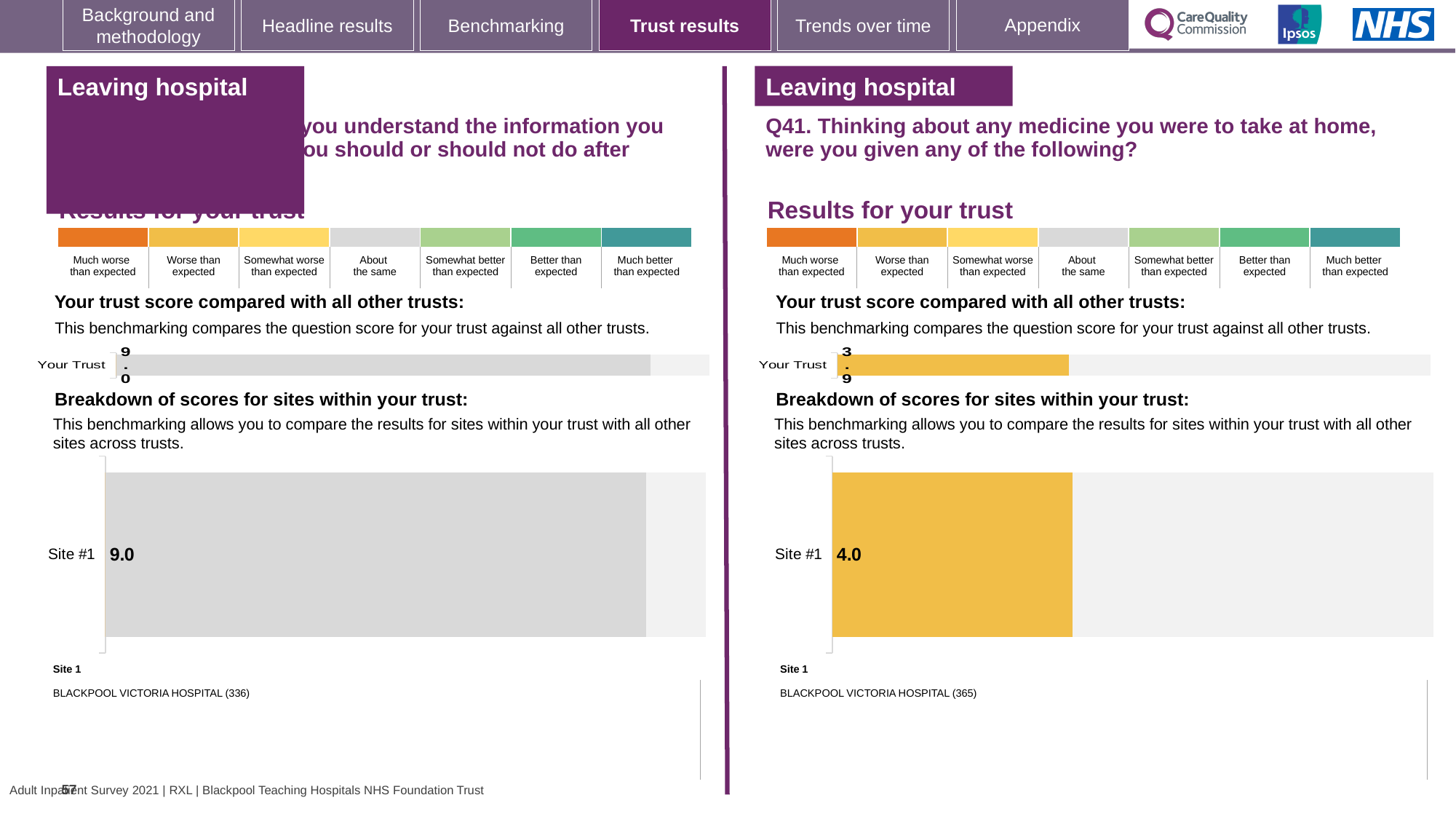
On the left-hand chart, which benchmark category does the colour of the Site #1 bar correspond to? About the same On the right-hand chart (Q41), which is larger: the Site #1 score or the Your Trust score? Site #1 On the left-hand chart, what is the score shown for Site #1? 9.0 On the left-hand chart, what is the score shown for Your Trust? 9.0 How many sites are shown in the site breakdown chart on the right-hand side (Q41)? 1 What type of chart is used to show the Site #1 score on the right-hand side of the slide? Bar chart On the right-hand chart (Q41), what is the score shown for Your Trust? 3.9 On the right-hand chart (Q41), what is the difference between the Site #1 score and the Your Trust score? 0.1 On the right-hand chart (Q41), what is the score shown for Site #1? 4.0 On the right-hand chart (Q41), which benchmark category does the colour of the Site #1 bar correspond to? Worse than expected Which Site #1 score is larger: the one on the left-hand chart or the one on the right-hand chart (Q41)? Left-hand chart Which hospital is listed as Site 1 on the right-hand side of the slide (Q41)? BLACKPOOL VICTORIA HOSPITAL (365)